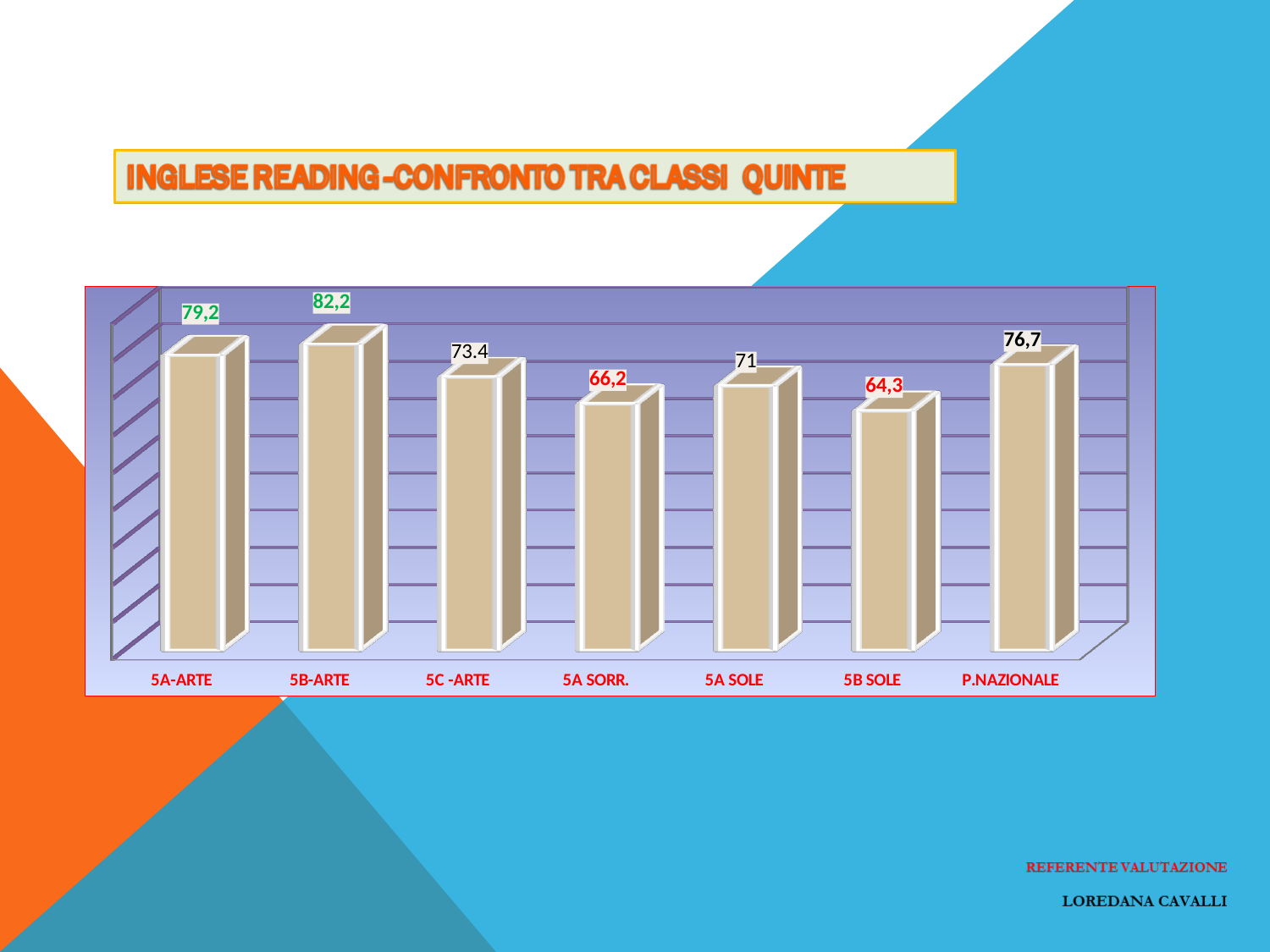
What kind of chart is shown on the slide? bar chart Which category has the lowest value? 5B SOLE Which category has the highest value? 5B-ARTE What is the value for 5A-ARTE? 79,2 What is the difference between the values for 5B-ARTE and 5B SOLE? 17,9 Which is larger, the value for 5A SOLE or the value for P.NAZIONALE? P.NAZIONALE What is the title of the slide's chart? INGLESE READING -CONFRONTO TRA CLASSI QUINTE What is the value for 5C -ARTE? 73.4 What is the value for P.NAZIONALE? 76,7 What is the value for 5B-ARTE? 82,2 What is the value for 5A SORR.? 66,2 How many categories are shown on the chart? 7